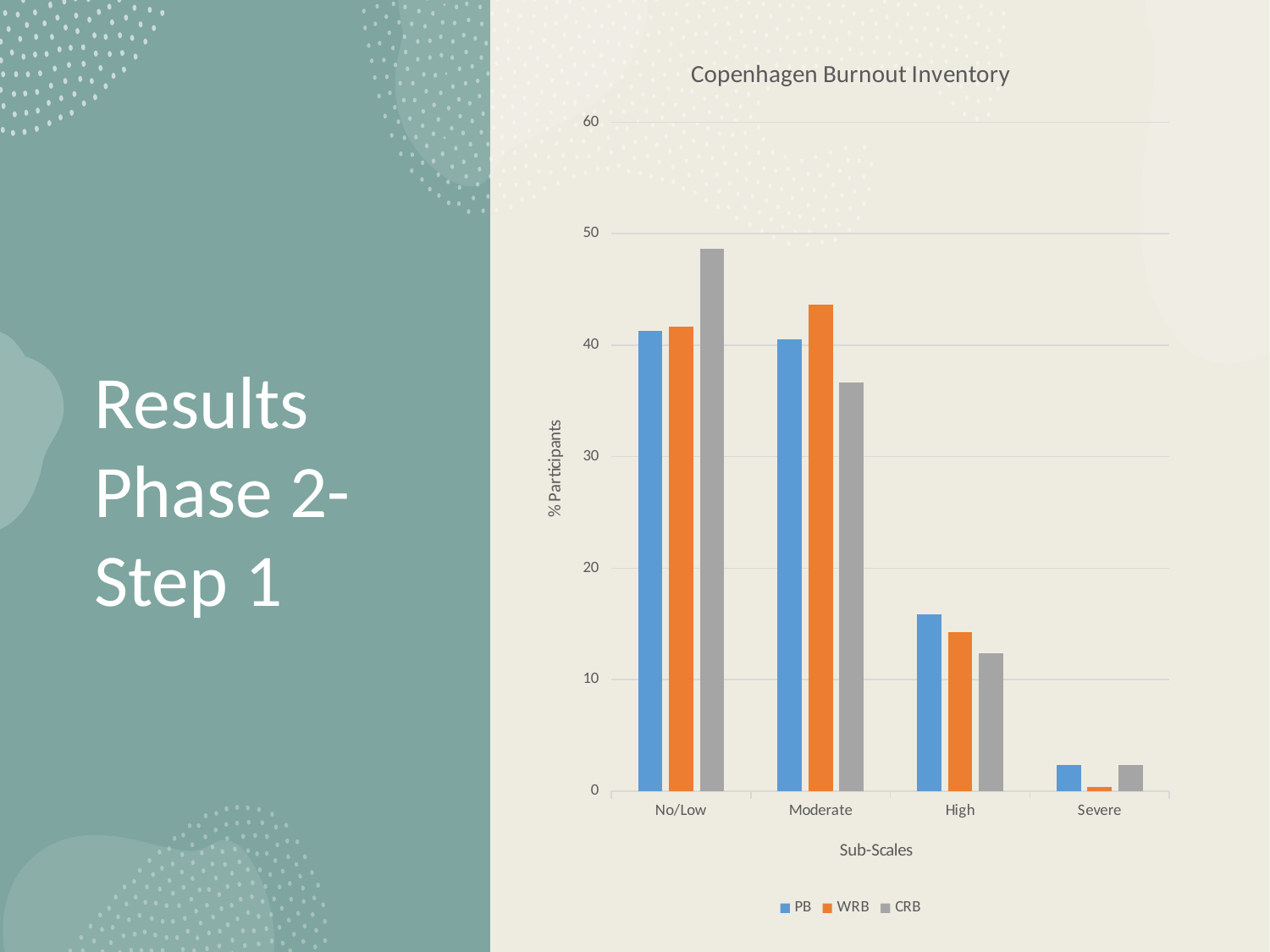
Is the CRB value for No/Low greater or less than 40? greater Is the PB value for High greater or less than 20? less How many sub-scale categories are shown on the x axis? 4 Which category has the highest CRB value? No/Low What is the label on the vertical axis? % Participants Do the CRB values rise or fall moving from No/Low to Severe along the x axis? fall In the Moderate category, which is larger, WRB or CRB? WRB How many series does the legend list? 3 What is the title of the chart? Copenhagen Burnout Inventory Is the WRB value for Moderate greater or less than 40? greater What kind of chart is shown on the slide? bar chart Which category has the lowest WRB value? Severe